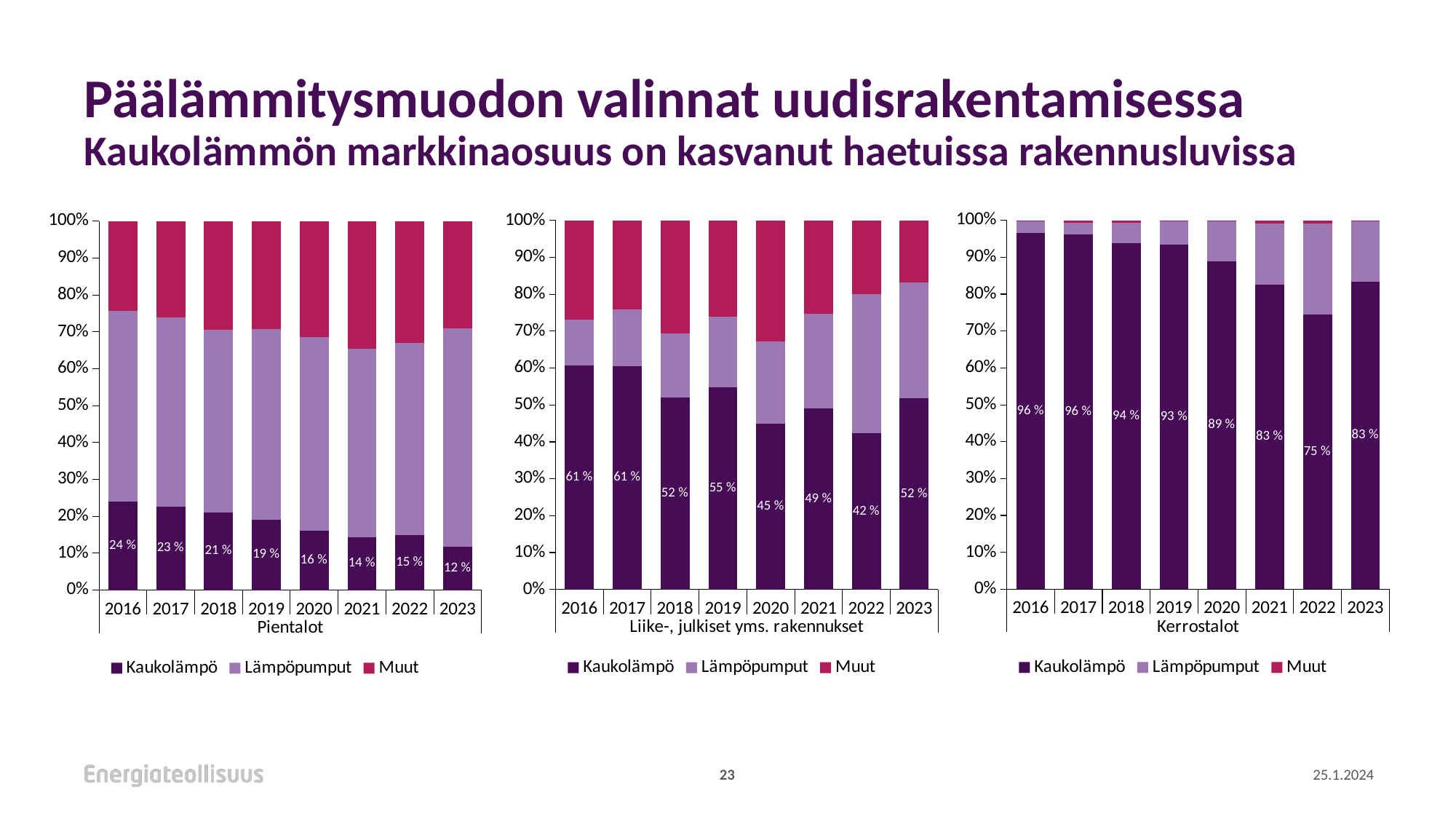
How many series does the legend of the Pientalot chart list? 3 In the Pientalot chart, which year has the lowest Kaukolämpö share? 2023 In the Kerrostalot chart, by how many percentage points does the Kaukolämpö share in 2016 exceed that in 2022? 21 % In the Liike-, julkiset yms. rakennukset chart, what is the Kaukolämpö share for 2020? 45 % In the Pientalot chart, does the Kaukolämpö share generally rise or fall from 2016 to 2023? fall In the Pientalot chart, is the top of the Lämpöpumput segment for 2021 greater or less than 70%? less How many years are shown on the x axis of the Kerrostalot chart? 8 In the Liike-, julkiset yms. rakennukset chart, which year has the lowest Kaukolämpö share? 2022 In the Liike-, julkiset yms. rakennukset chart, is the Kaukolämpö share larger in 2019 or in 2021? 2019 In the Kerrostalot chart, what is the Kaukolämpö share for 2022? 75 % In the Pientalot chart, what is the Kaukolämpö share for 2016? 24 % In the Pientalot chart, what is the difference between the Kaukolämpö share in 2016 and in 2023? 12 %